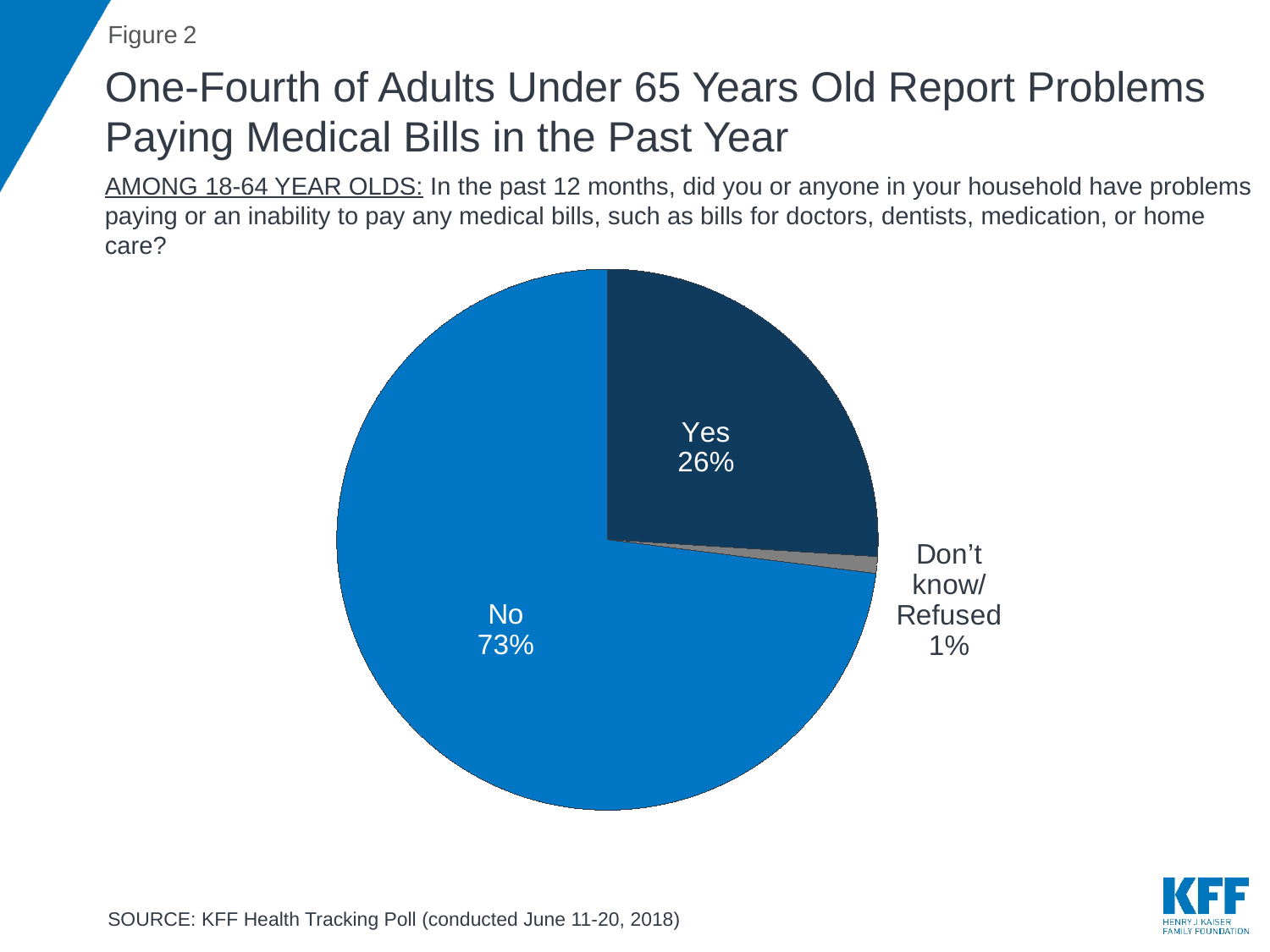
What is the difference in percentage points between the "No" and "Yes" slices? 47 Which response has the smallest slice of the pie? Don't know/Refused What is the source cited for the chart's data? KFF Health Tracking Poll (conducted June 11-20, 2018) What share of the pie is labeled "Don't know/Refused"? 1% What percentage of 18-64 year olds answered "Yes" to having problems paying medical bills? 26% What is the title of the chart on the slide? One-Fourth of Adults Under 65 Years Old Report Problems Paying Medical Bills in the Past Year Is the "Yes" share greater or less than 50%? less Which response has the largest slice of the pie? No Which is larger, the "Yes" slice or the "No" slice? No What kind of chart is shown on the slide? pie chart How many slices does the pie chart have? 3 What percentage of respondents answered "No"? 73%